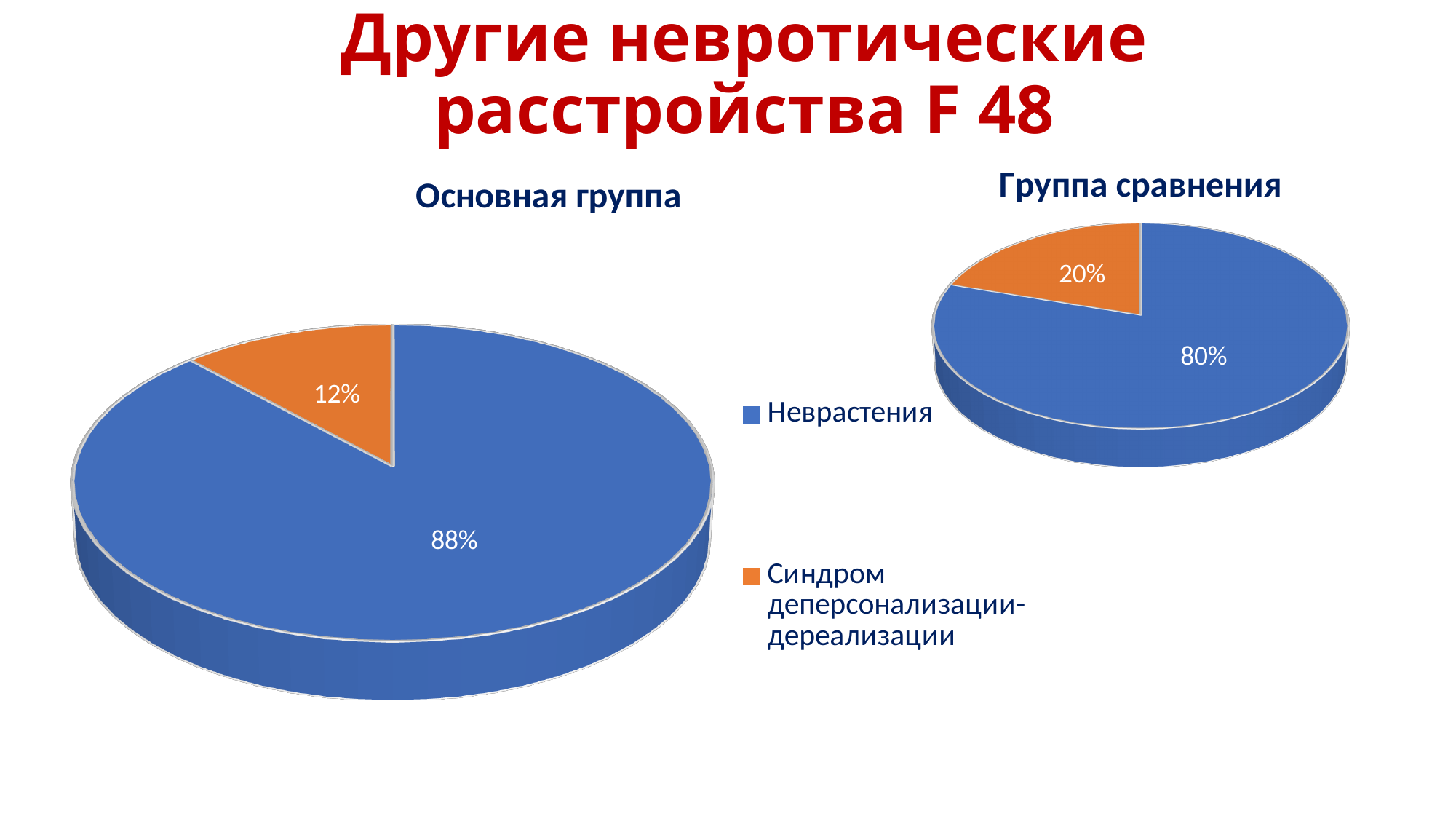
Which chart shows a larger share for Синдром деперсонализации-дереализации, 'Основная группа' or 'Группа сравнения'? Группа сравнения In the 'Основная группа' chart, what is the difference between the Неврастения and Синдром деперсонализации-дереализации shares? 76% In the 'Группа сравнения' chart, what is the difference between the Неврастения and Синдром деперсонализации-дереализации shares? 60% In the 'Основная группа' chart, what share does Неврастения have? 88% In the 'Группа сравнения' chart, what share does Синдром деперсонализации-дереализации have? 20% In the 'Группа сравнения' chart, which category has the smallest slice? Синдром деперсонализации-дереализации Which colour represents Неврастения in the charts? Blue In the 'Основная группа' chart, what share does Синдром деперсонализации-дереализации have? 12% What type of chart is the 'Основная группа' chart? Pie chart How many categories does the legend list? 2 In the 'Группа сравнения' chart, what share does Неврастения have? 80% In the 'Основная группа' chart, which category has the largest slice? Неврастения